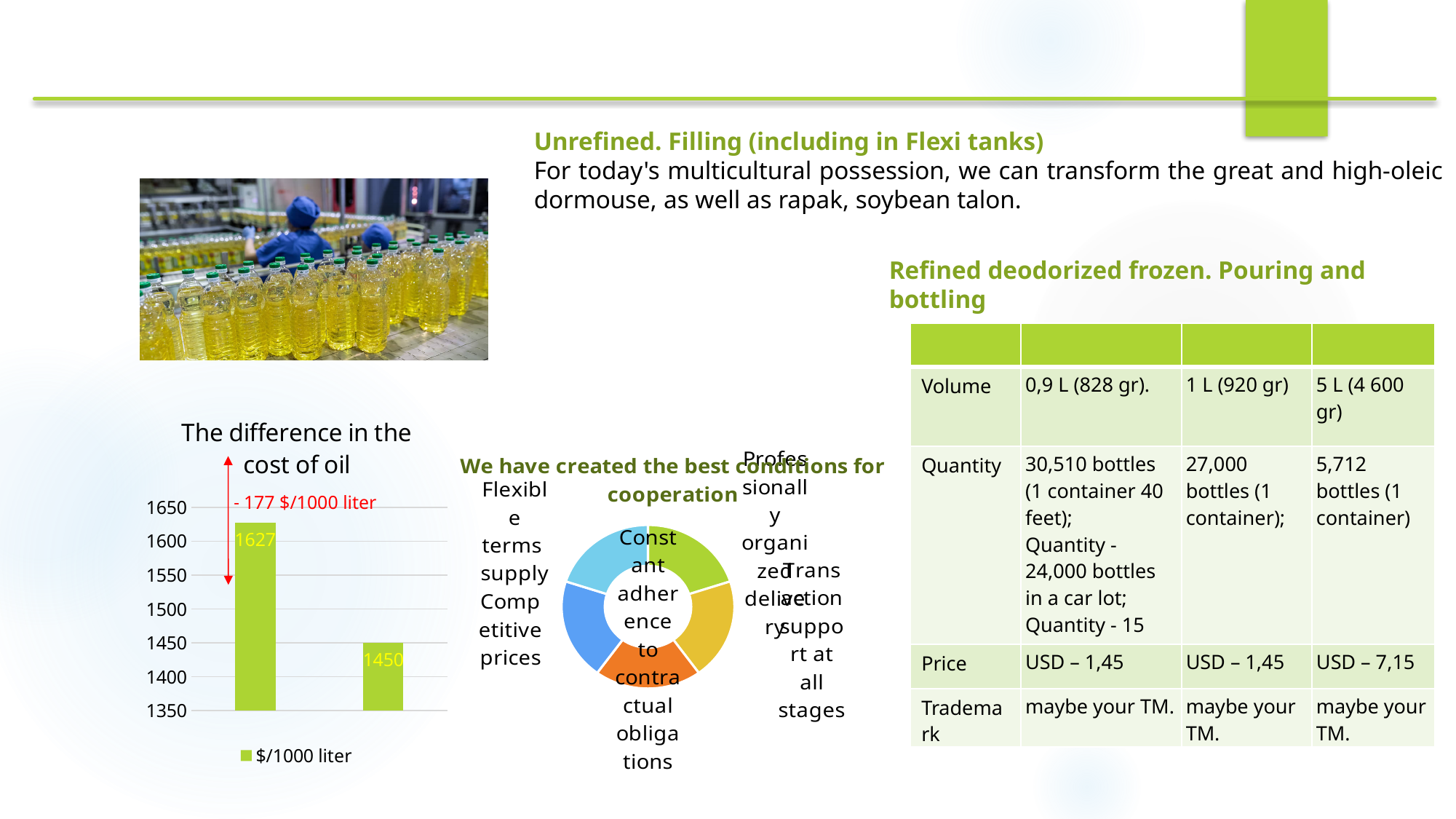
What kind of chart is 'The difference in the cost of oil'? bar chart In the chart titled 'The difference in the cost of oil', do the values rise or fall from left to right? fall What kind of chart is the ring-shaped chart in the middle of the slide? doughnut chart In the chart titled 'The difference in the cost of oil', how many bars are plotted? 2 What is the legend entry of the chart titled 'The difference in the cost of oil'? $/1000 liter How many segments does the doughnut chart in the middle of the slide have? 5 In the chart titled 'The difference in the cost of oil', what is the difference between the two bars? 177 In the chart titled 'The difference in the cost of oil', what is the value of the left bar? 1627 In the chart titled 'The difference in the cost of oil', which bar is taller, the left or the right? left In the chart titled 'The difference in the cost of oil', is the value of the right bar greater or less than 1500? less In the chart titled 'The difference in the cost of oil', how many series does the legend list? 1 In the chart titled 'The difference in the cost of oil', what is the value of the right bar? 1450